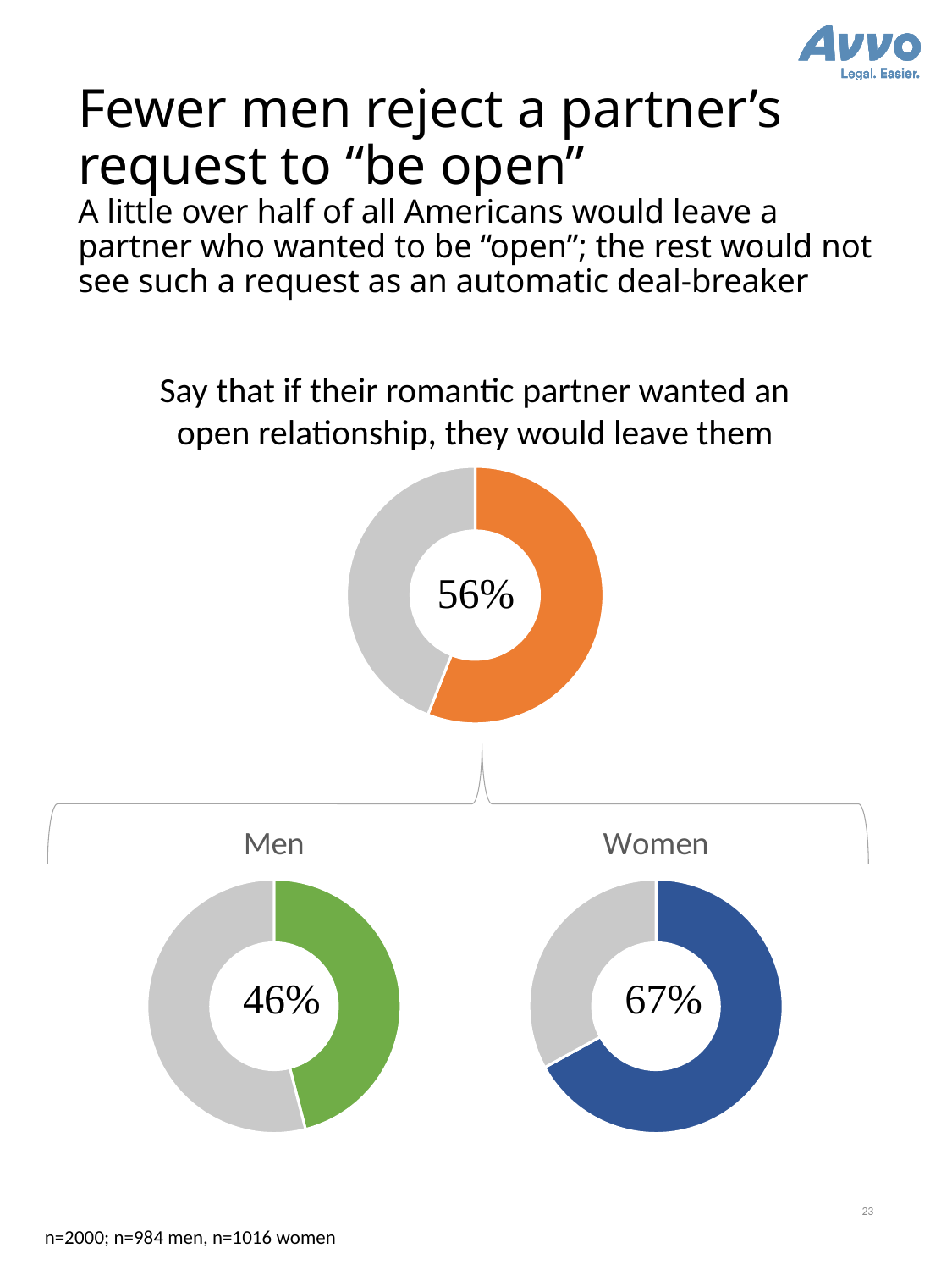
How many doughnut charts are shown on the slide? 3 What colour is the highlighted segment in the Women chart? Blue Comparing the Men and Women charts, which group has the higher share saying they would leave? Women What is the difference in percentage points between the Women chart value and the overall top chart value? 11 Is the value shown in the Women chart greater or less than 50%? greater What is the difference in percentage points between the Women chart value and the Men chart value? 21 In the Men chart, what percentage of men say they would leave a partner who wanted an open relationship? 46% In the top chart, what percentage say they would leave a partner who wanted an open relationship? 56% Is the value shown in the Men chart greater or less than 50%? less What is the difference in percentage points between the overall top chart value and the Men chart value? 10 What kind of chart is used to show the 56% value at the top of the slide? Doughnut chart In the Women chart, what percentage of women say they would leave a partner who wanted an open relationship? 67%